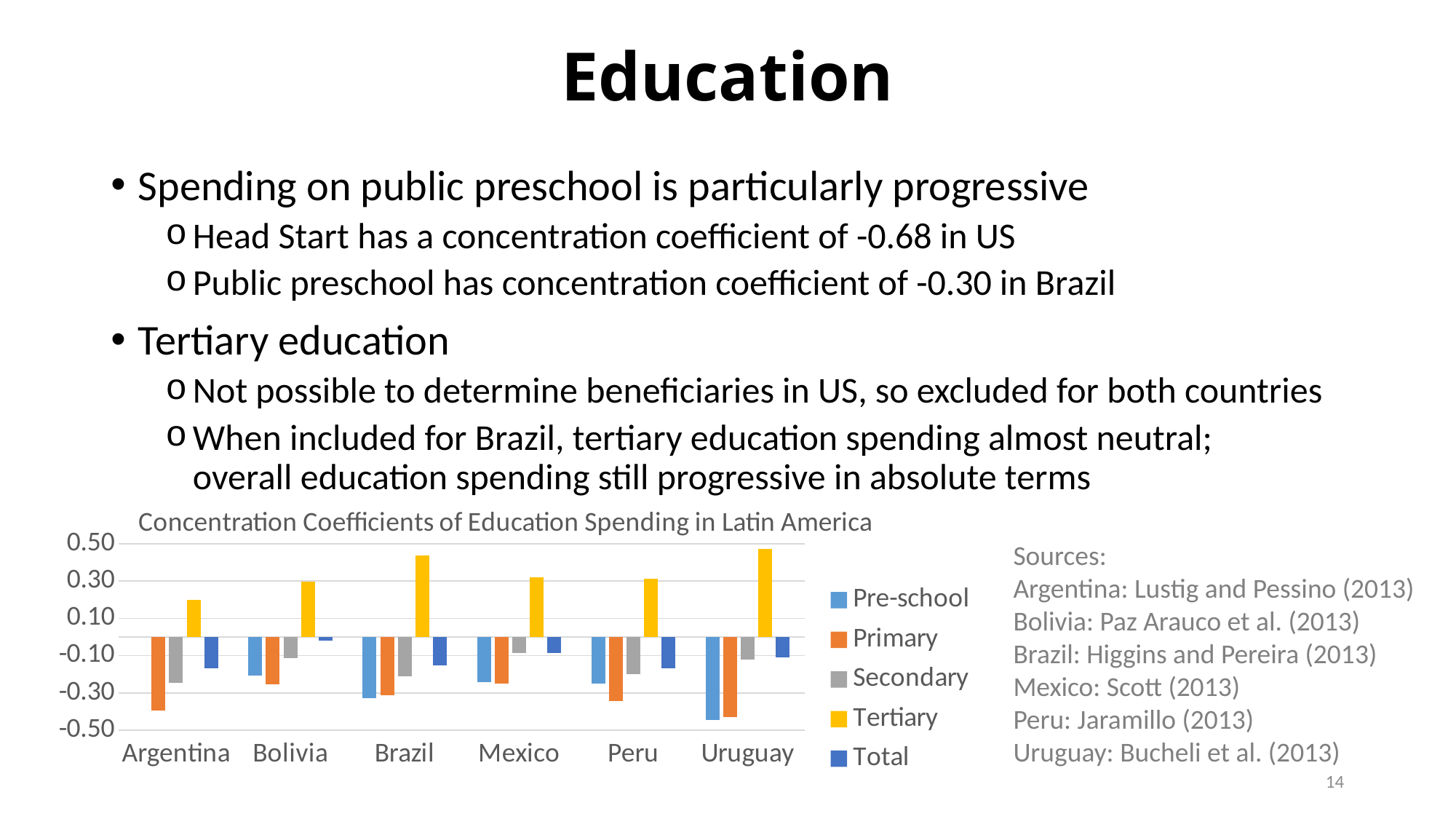
Is the Tertiary value for Brazil greater or less than 0.30? greater How many series does the chart legend list? 5 Which series is shown in yellow in the chart? Tertiary What is the title of the chart? Concentration Coefficients of Education Spending in Latin America Which country has the lowest Pre-school concentration coefficient? Uruguay Is the Tertiary value for Argentina greater or less than 0.30? less Which country has the lowest Primary concentration coefficient? Uruguay Which is larger, the Tertiary value for Argentina or the Tertiary value for Bolivia? Bolivia Is the Pre-school value for Uruguay greater or less than -0.30? less What kind of chart is shown on the slide? bar chart How many countries are shown on the x axis of the chart? 6 Which is larger, the Primary value for Mexico or the Primary value for Peru? Mexico